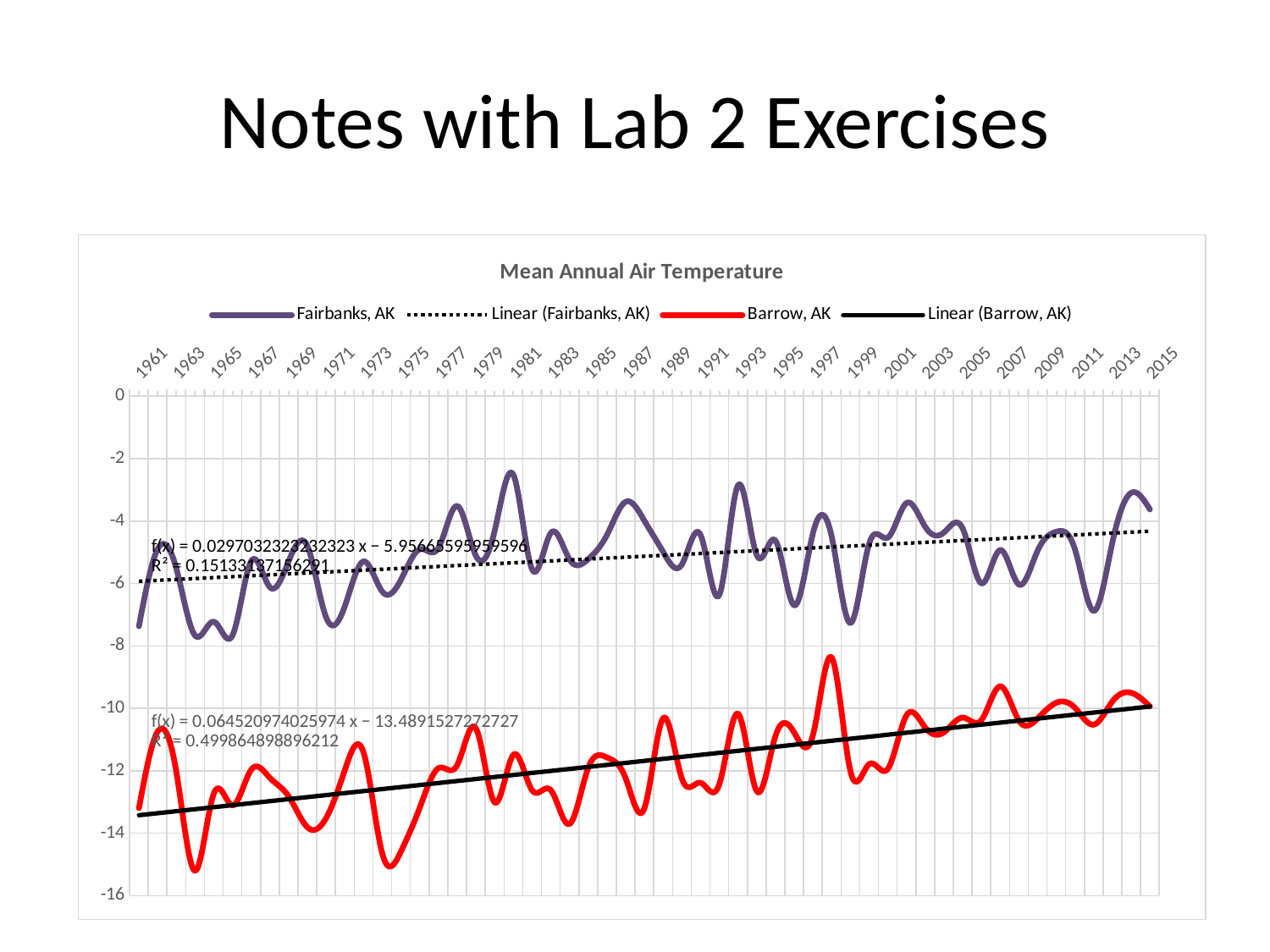
Does the linear trendline for Barrow, AK rise or fall from 1961 to 2015? rise Is the peak value for Fairbanks, AK near 1980 greater or less than -4? greater Does the linear trendline for Fairbanks, AK rise or fall across the years shown? rise What is the title of the chart? Mean Annual Air Temperature What kind of chart is shown on the slide? line chart Is the value for Fairbanks, AK in 1961 greater or less than -6? less What R² value is printed for the Barrow, AK trendline? 0.499864898896212 How many entries does the chart legend list? 4 Which series has higher mean annual air temperatures throughout the chart, Fairbanks, AK or Barrow, AK? Fairbanks, AK Is the peak value for Barrow, AK near 1997 greater or less than -10? greater How many year labels are shown on the x axis? 28